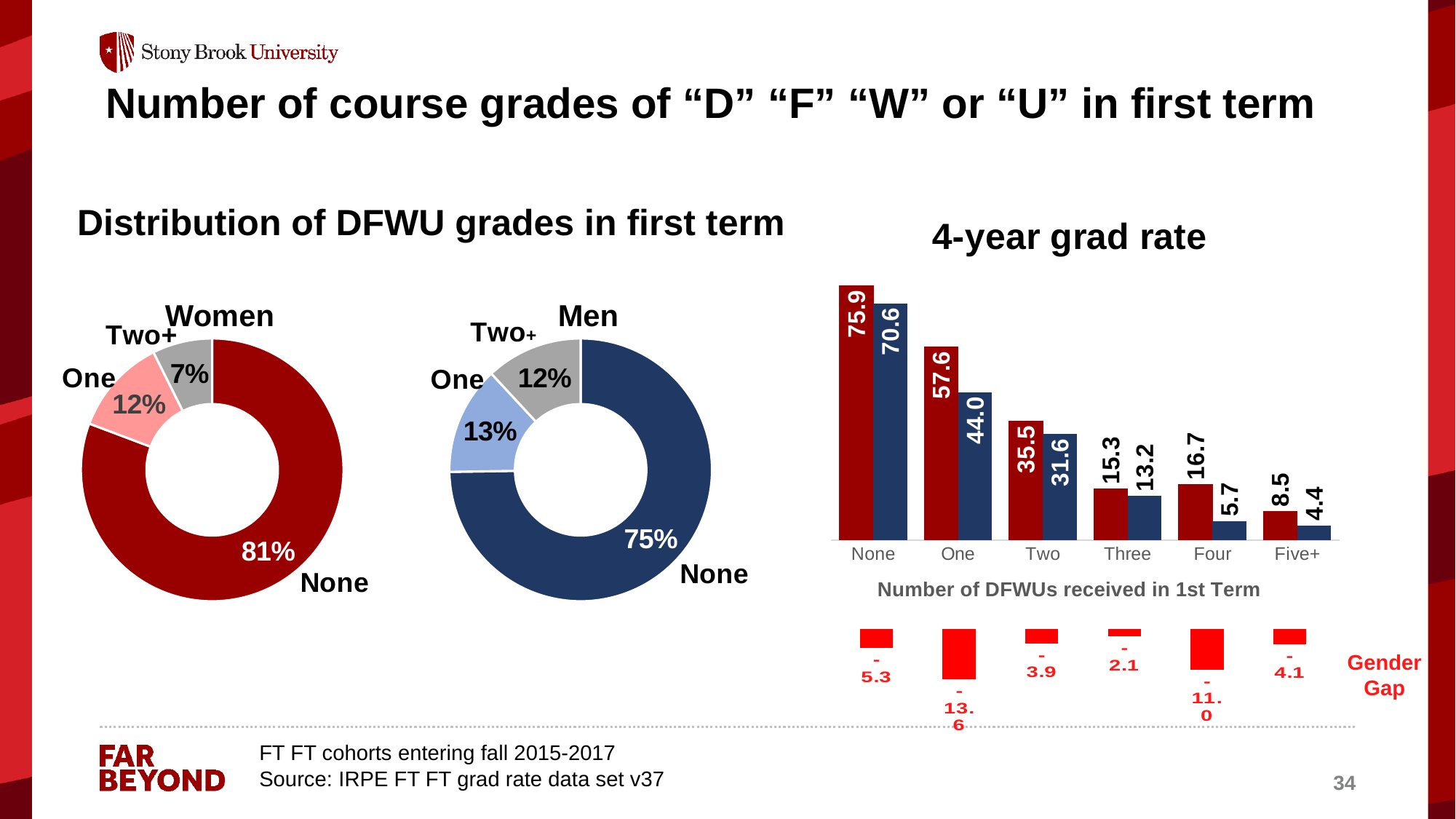
How many categories are shown on the x axis of the 4-year grad rate chart? 6 In the Men donut chart, which category has the smallest share? Two+ In the Women donut chart, what share of students had no DFWU grades in the first term? 81% In the 4-year grad rate chart, what is the value of the red bar for the None category? 75.9 What kind of chart is used to show the distribution of DFWU grades for Women and Men? Donut (pie) chart In the Gender Gap chart, what is the value for the Three category? -2.1 In the Women donut chart, what is the value for the One category? 12% In the 4-year grad rate chart, what is the value of the blue bar for the Four category? 5.7 In the 4-year grad rate chart, which category has the lowest blue bar? Five+ In the Gender Gap chart, which category has the largest gap? One In the Men donut chart, what share of students received two or more DFWU grades? 12% In the 4-year grad rate chart, what is the difference between the red and blue bars for the One category? 13.6